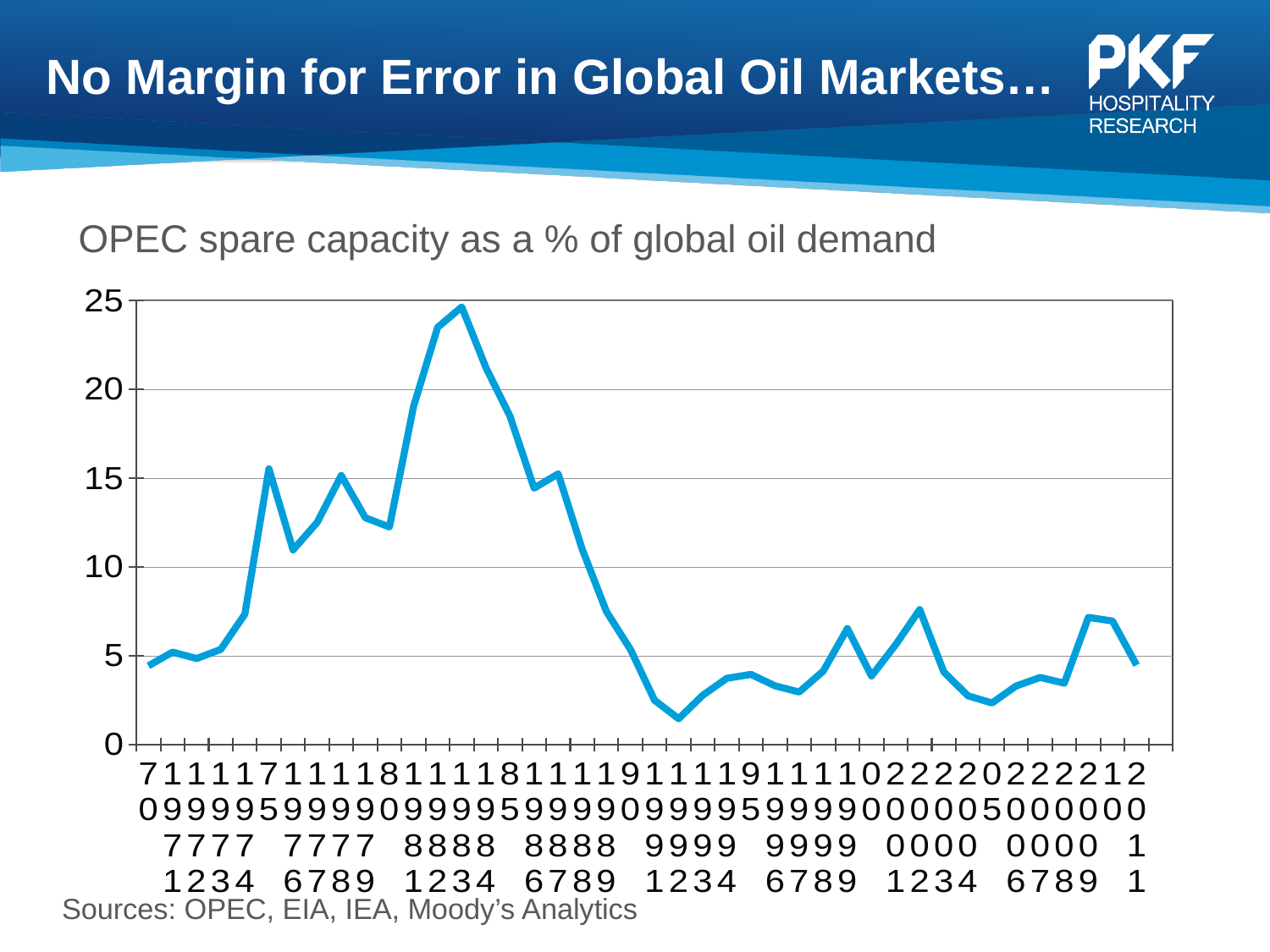
Which is larger, the value for 1983 or the value for 2011? 1983 In which year does OPEC spare capacity as a % of global oil demand reach its highest point? 1983 Is the value for 1975 greater or less than 10? greater Is the value for 2011 greater or less than 10? less Is the value for 1983 greater or less than 20? greater What is the highest value shown on the vertical axis of the chart? 25 What is the title of the chart? OPEC spare capacity as a % of global oil demand What kind of chart is shown on the slide? line chart Does the line rise or fall between 1983 and 1992? fall